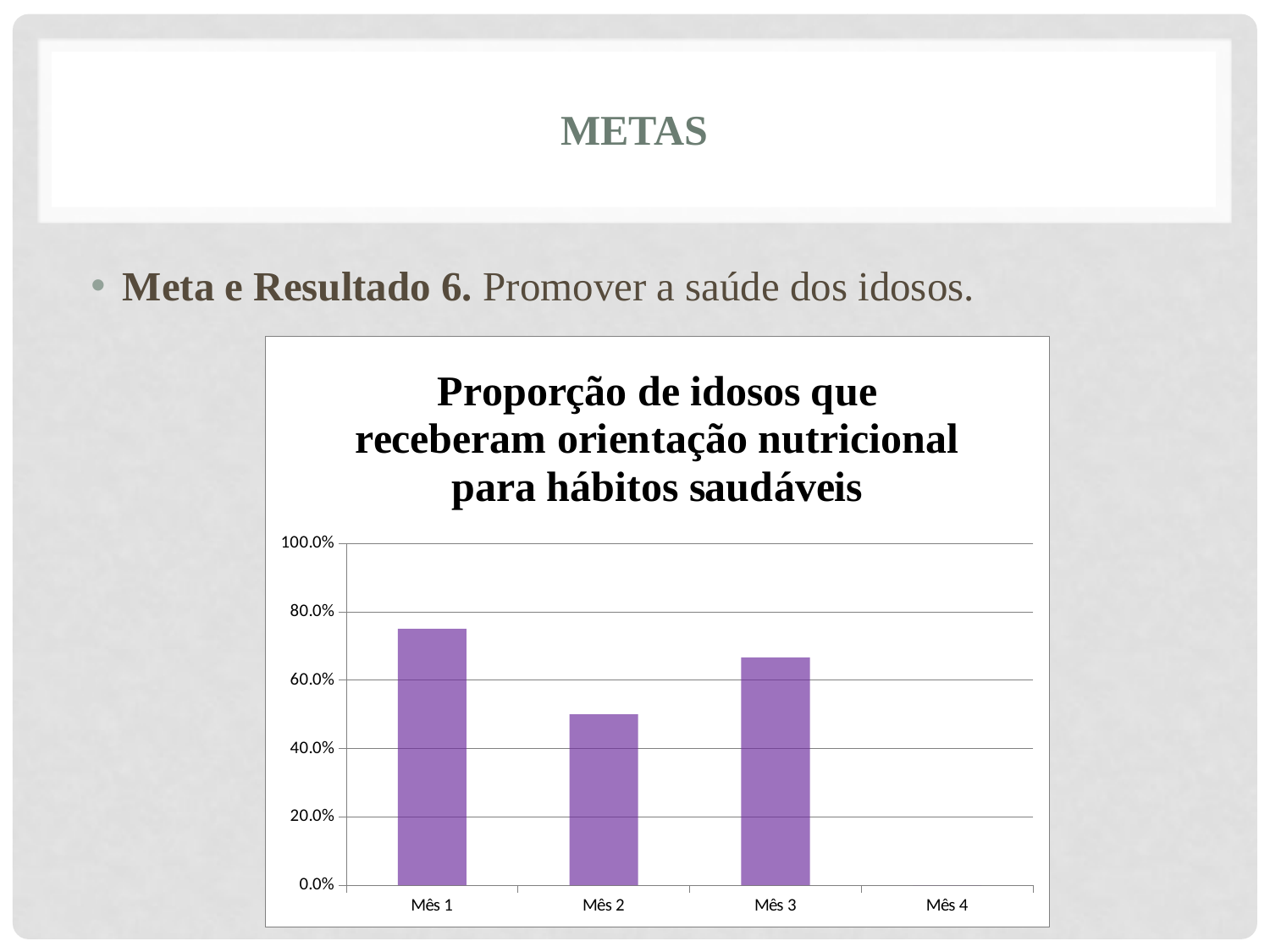
Among Mês 1, Mês 2 and Mês 3, which month has the lowest bar? Mês 2 Which is larger, the value for Mês 1 or the value for Mês 3? Mês 1 How many categories are shown on the x axis of the chart? 4 Is the value for Mês 2 greater or less than 40.0%? greater What is the title of the chart? Proporção de idosos que receberam orientação nutricional para hábitos saudáveis Which month has no visible bar in the chart? Mês 4 Which month has the highest bar in the chart? Mês 1 Is the value for Mês 3 greater or less than 60.0%? greater Is the value for Mês 2 greater or less than 60.0%? less What kind of chart is shown on the slide? bar chart